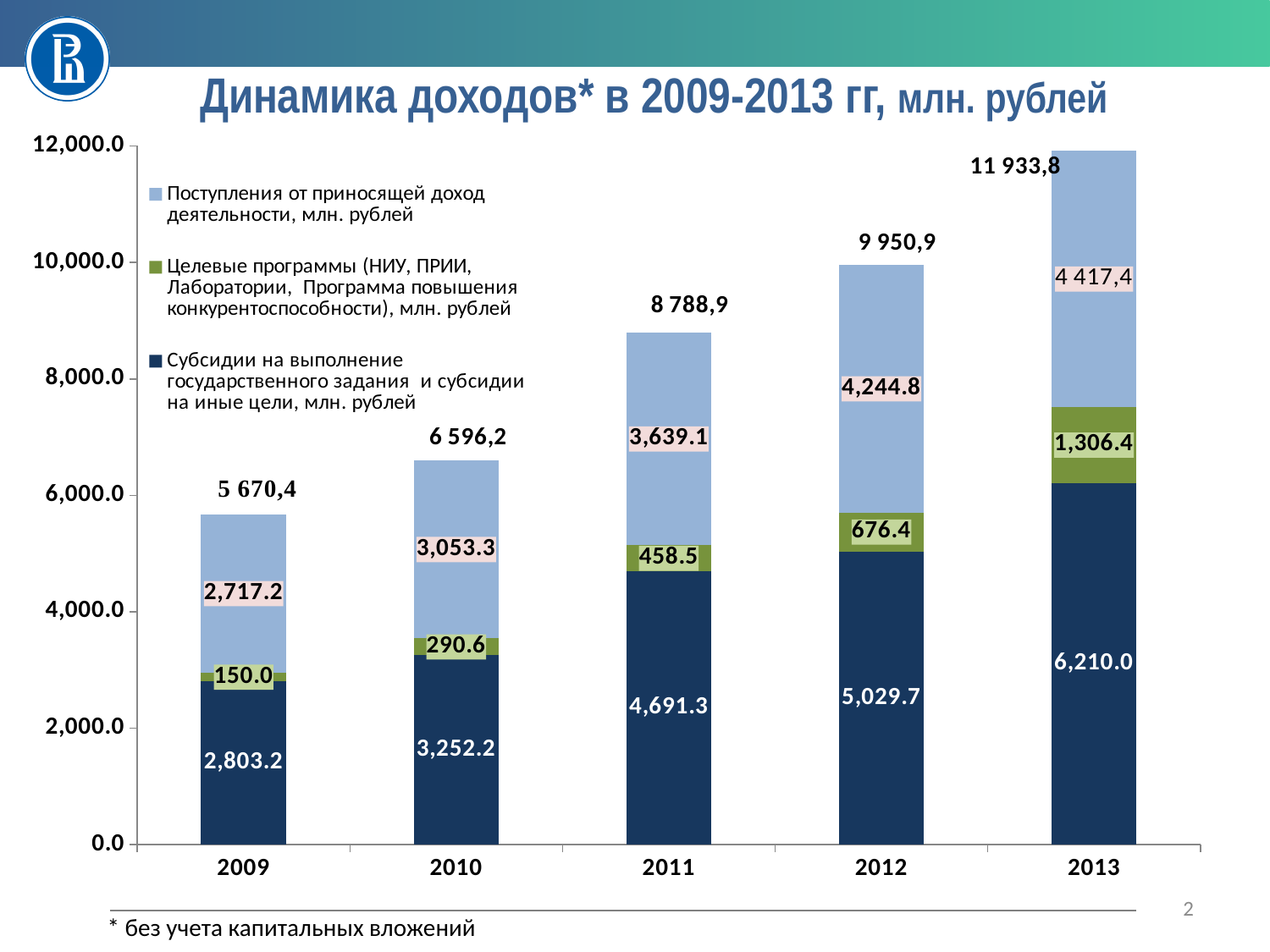
How many years are shown on the x axis? 5 Do total incomes rise or fall from 2009 to 2013? Rise How many series does the legend list? 3 What is the value of income from revenue-generating activities (Поступления от приносящей доход деятельности) in 2013? 4 417,4 By how much did subsidies increase from 2012 to 2013? 1,180.3 In 2011, which is larger: subsidies or income from revenue-generating activities? Subsidies (4,691.3) What is the value of subsidies for state assignment (Субсидии на выполнение государственного задания) in 2011? 4,691.3 In which year is the subsidies segment (dark blue) the largest? 2013 In which year is the targeted programs segment (green) the smallest? 2009 What is the value of targeted programs (Целевые программы) in 2012? 676.4 What is the total income shown above the bar for 2010? 6 596,2 What kind of chart is shown on the slide? Stacked bar chart